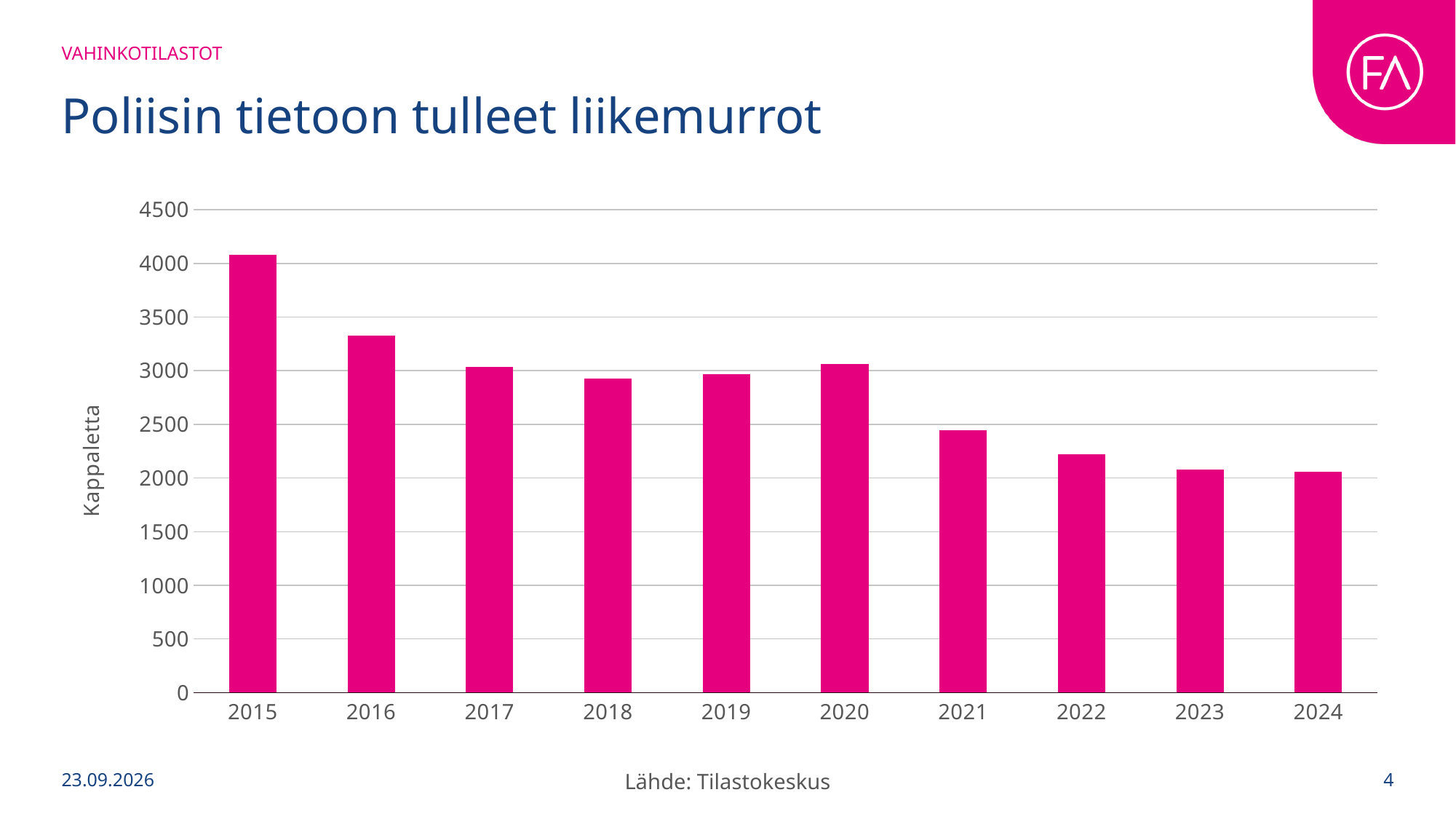
Is the value for 2018 greater or less than 3000? less Do the values generally rise or fall from 2015 to 2024? fall What is the label on the y axis of the chart? Kappaletta What kind of chart is shown on the slide? bar chart Which is larger, the value for 2015 or the value for 2016? 2015 Is the value for 2015 greater or less than 4000? greater Which year has the highest number of liikemurrot in the chart? 2015 Is the value for 2016 greater or less than 3500? less Which is larger, the value for 2021 or the value for 2022? 2021 How many years are shown on the x axis of the chart? 10